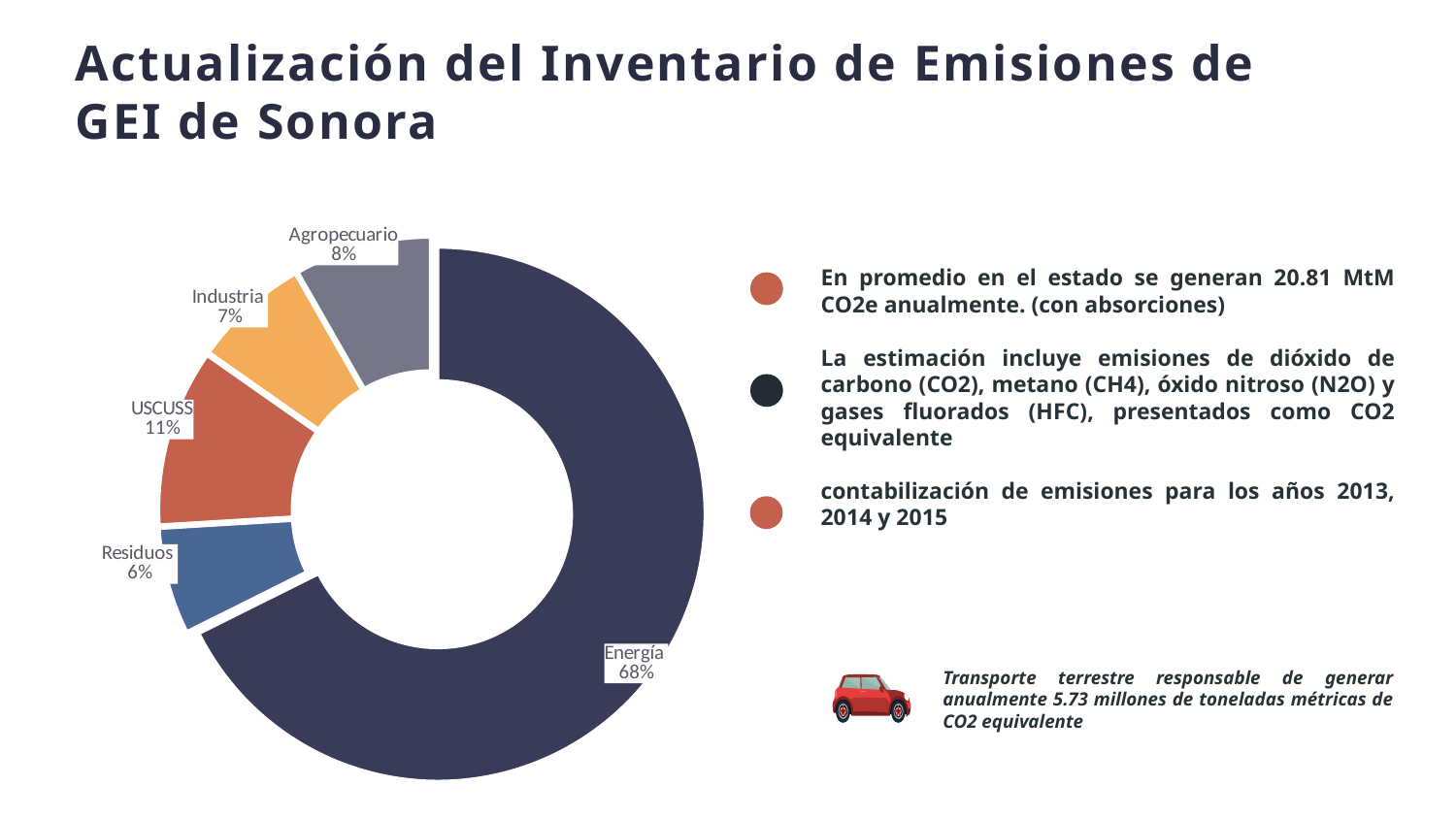
What percentage is shown for Residuos in the chart? 6% Which category has the smallest share in the chart? Residuos What percentage is shown for USCUSS in the chart? 11% What colour is the Energía segment of the chart? Dark navy blue Which has a larger share, USCUSS or Industria? USCUSS What type of chart is shown on the slide? Doughnut chart How many categories are shown in the chart? 5 What is the difference in percentage points between Energía and USCUSS? 57 What share of the doughnut chart does Energía represent? 68% Which category has the largest share in the chart? Energía What percentage is shown for Agropecuario in the chart? 8% What is the difference in percentage points between Agropecuario and Industria? 1